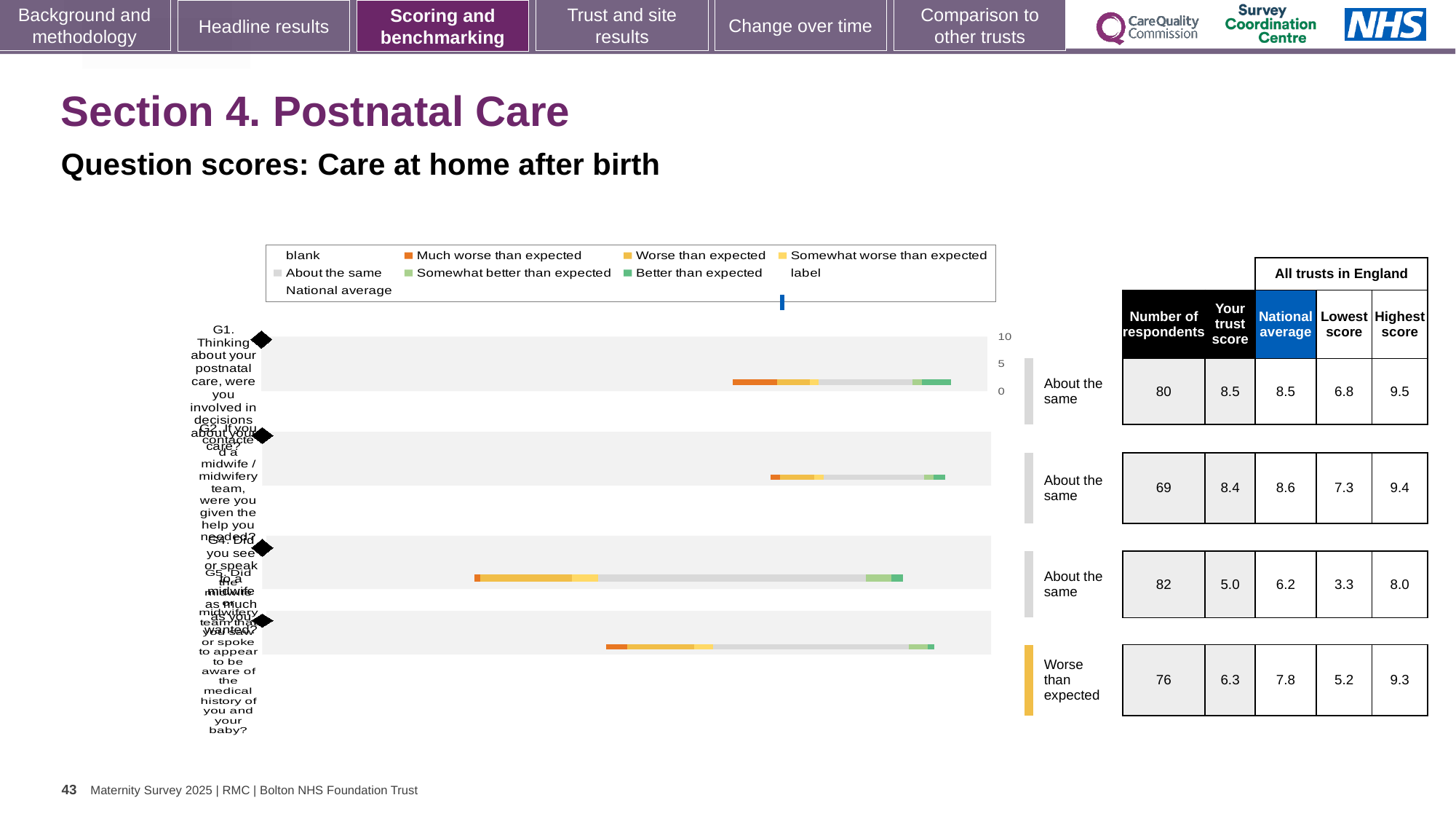
How many of the four question rows are rated 'About the same'? 3 For the second row (G2), which is larger: the trust score or the national average? the national average What is the trust score for the second row (G2)? 8.4 What is the national average for the third row? 6.2 What kind of chart is shown on the slide? bar chart What is the highest score in England for the fourth (bottom) row? 9.3 Which question row is rated 'Worse than expected'? the fourth (bottom) row What is the number of respondents for the first row (G1)? 80 How many question rows (bars) are plotted in the chart? 4 Which row has the lowest trust score? the third row (5.0) Which row has the highest number of respondents? the third row (82) For the fourth (bottom) row, what is the difference between the national average and the trust score? 1.5